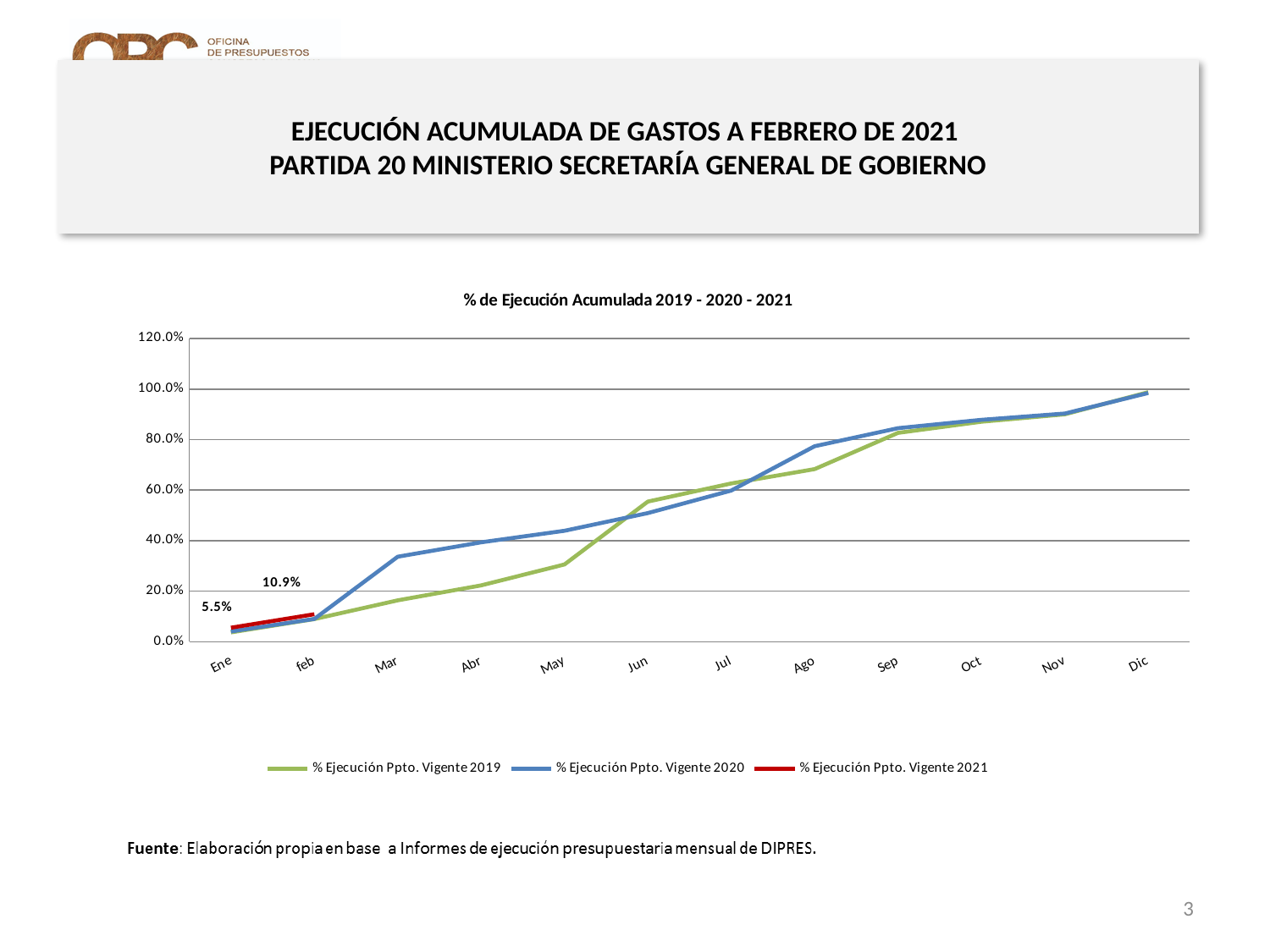
How many months are shown on the x axis? 12 How many series does the legend list? 3 Do the values of % Ejecución Ppto. Vigente 2019 rise or fall from Ene to Dic? rise What is the difference between the feb and Ene values of % Ejecución Ppto. Vigente 2021? 5.4% Is the value for % Ejecución Ppto. Vigente 2020 in Mar greater or less than 20.0%? greater What colour is the line for % Ejecución Ppto. Vigente 2021? red What is the value of % Ejecución Ppto. Vigente 2021 for feb? 10.9% In which month does % Ejecución Ppto. Vigente 2020 reach its highest value? Dic Is the value for % Ejecución Ppto. Vigente 2019 in May greater or less than 40.0%? less What is the value of % Ejecución Ppto. Vigente 2021 for Ene? 5.5% In Mar, which series has the larger value, % Ejecución Ppto. Vigente 2019 or % Ejecución Ppto. Vigente 2020? % Ejecución Ppto. Vigente 2020 What kind of chart is shown on the slide? line chart